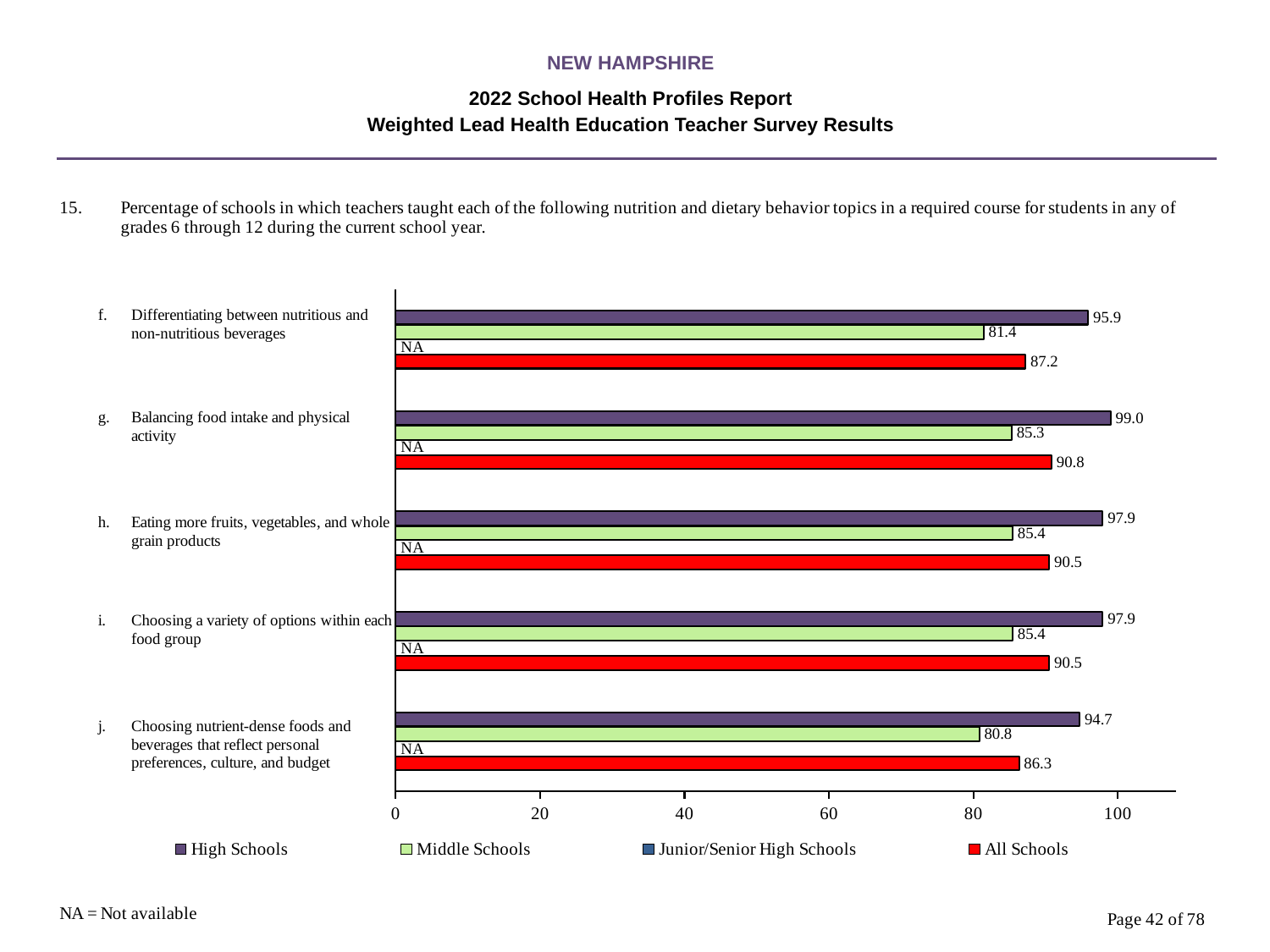
What is the High Schools value for 'Balancing food intake and physical activity'? 99.0 What kind of chart is this? bar chart What is the difference between the High Schools and Middle Schools values for 'Balancing food intake and physical activity'? 13.7 Which colour represents All Schools in the legend? red What is shown for Junior/Senior High Schools for 'Eating more fruits, vegetables, and whole grain products'? NA How many series does the legend list? 4 Which is larger: the All Schools value for 'Differentiating between nutritious and non-nutritious beverages' or the All Schools value for 'Balancing food intake and physical activity'? Balancing food intake and physical activity Which topic has the lowest Middle Schools value? Choosing nutrient-dense foods and beverages that reflect personal preferences, culture, and budget What is the Middle Schools value for 'Differentiating between nutritious and non-nutritious beverages'? 81.4 Which topic has the highest High Schools value? Balancing food intake and physical activity What is the All Schools value for 'Choosing nutrient-dense foods and beverages that reflect personal preferences, culture, and budget'? 86.3 How many topics are listed on the chart? 5